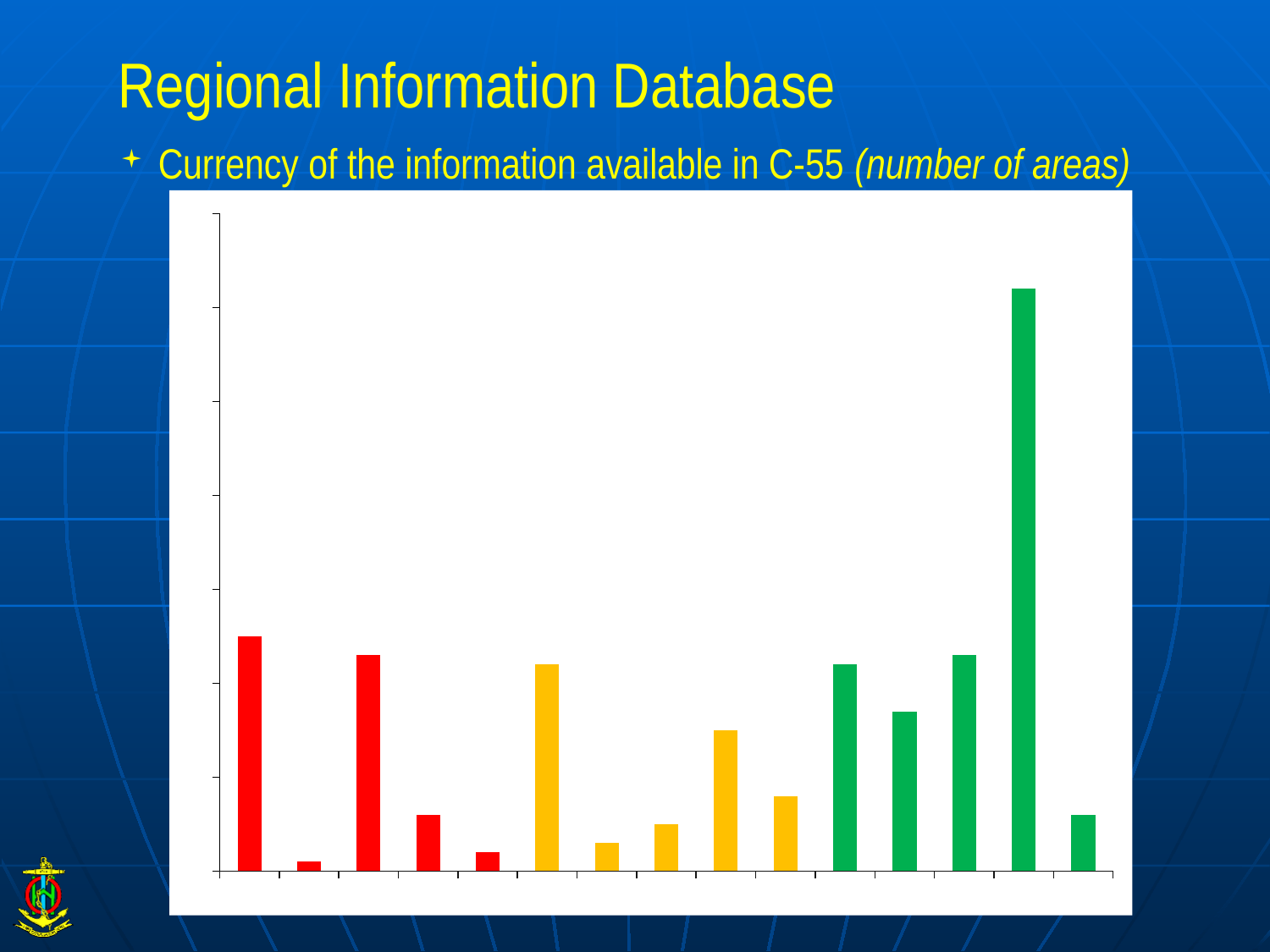
How many bars are plotted in the chart? 15 Counting from the left, which bar is the tallest in the chart? the 14th bar Counting from the left, which bar is the shortest in the chart? the 2nd bar What kind of chart is shown on the slide? bar chart Which is taller, the 6th bar from the left or the 7th bar from the left? the 6th bar How many different bar colours are used in the chart? 3 Which is taller, the last (15th) bar or the 14th bar? the 14th bar How many green bars are in the chart? 5 How many red bars are in the chart? 5 Which is taller, the first bar from the left or the second bar from the left? the first bar What colour is the tallest bar in the chart? green What colour are the bars in the middle group of the chart? yellow